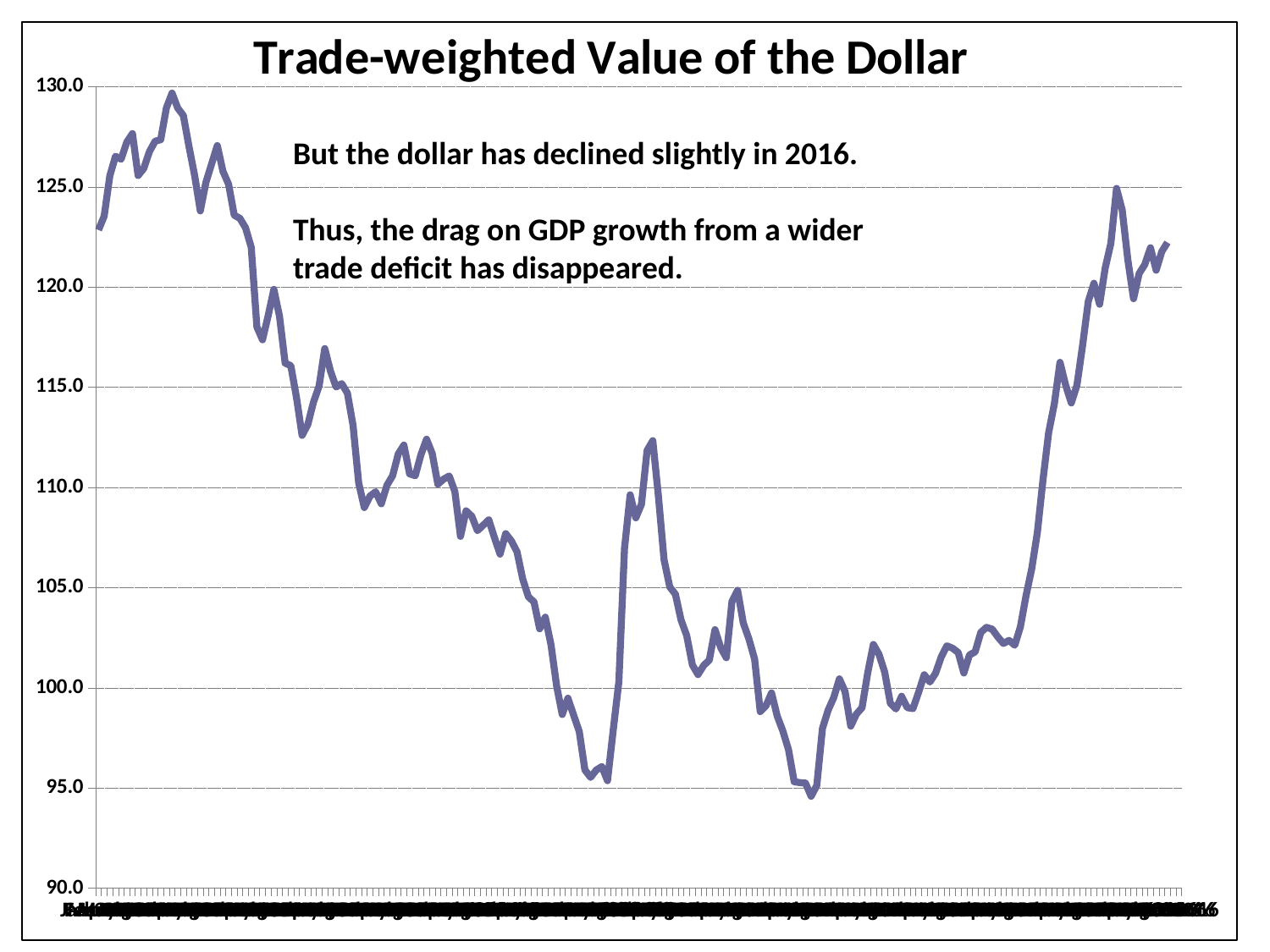
Does the line rise or fall from its starting point on the left to its lowest point? fall Is the highest point reached by the line greater or less than 125.0? greater What is the maximum value shown on the y-axis? 130.0 Is the value at the far right end of the line greater or less than 120.0? greater How many lines (series) are plotted on the chart? 1 What is the title of the chart? Trade-weighted Value of the Dollar Is the lowest point reached by the line greater or less than 100.0? less What kind of chart is shown on the slide? line chart